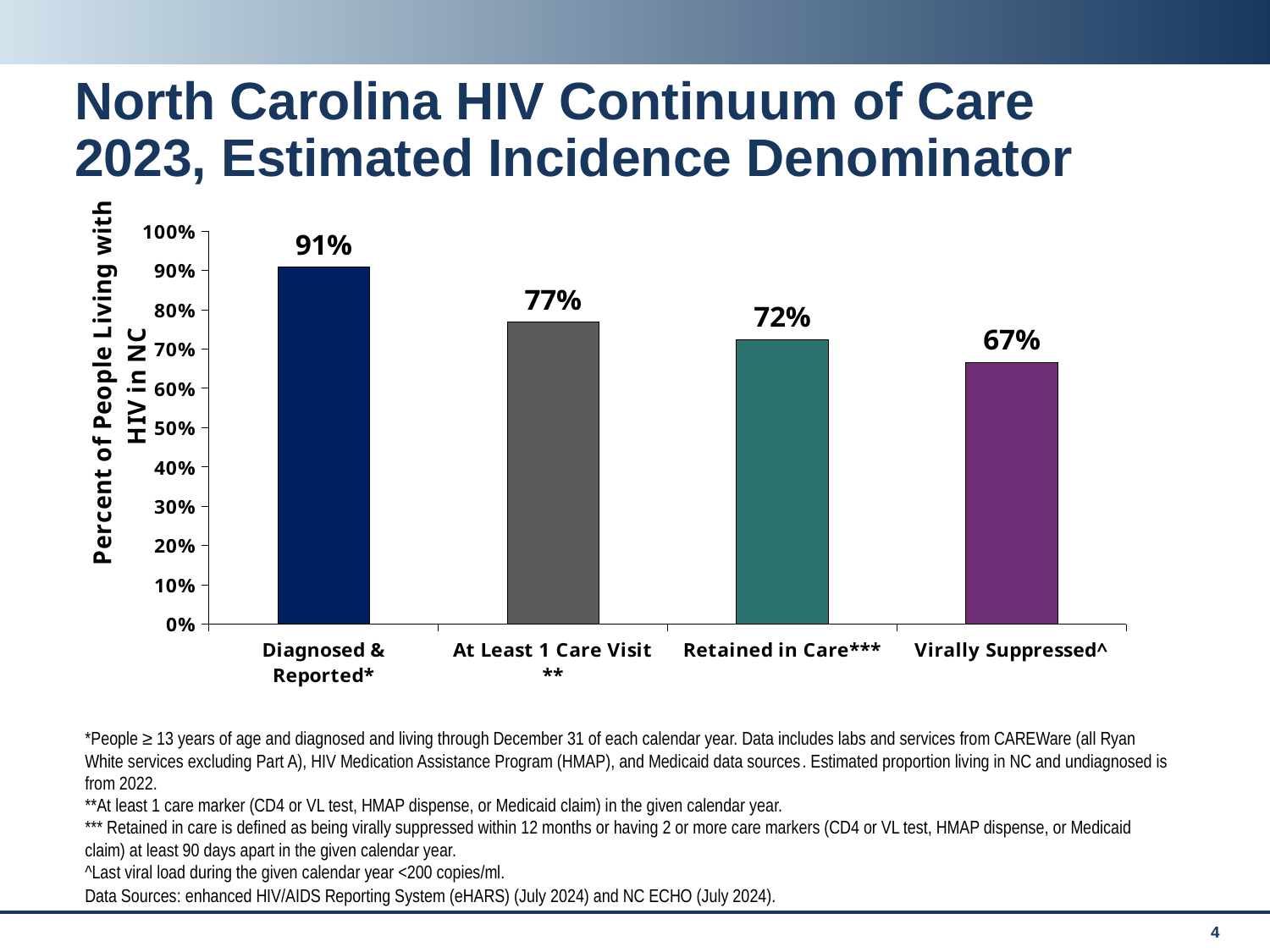
Which category has the lowest value? Virally Suppressed^ Which category has the highest value? Diagnosed & Reported* What is the difference between the values for At Least 1 Care Visit** and Retained in Care***? 5% What is the difference between the values for Diagnosed & Reported* and Virally Suppressed^? 24% How many categories are shown on the x axis? 4 Do the values rise or fall from left to right along the x axis? Fall What is the value for Diagnosed & Reported*? 91% What is the value for Retained in Care***? 72% What kind of chart is shown on the slide? Bar chart What is the value for At Least 1 Care Visit**? 77% Which is larger, the value for Retained in Care*** or the value for Virally Suppressed^? Retained in Care*** What is the value for Virally Suppressed^? 67%